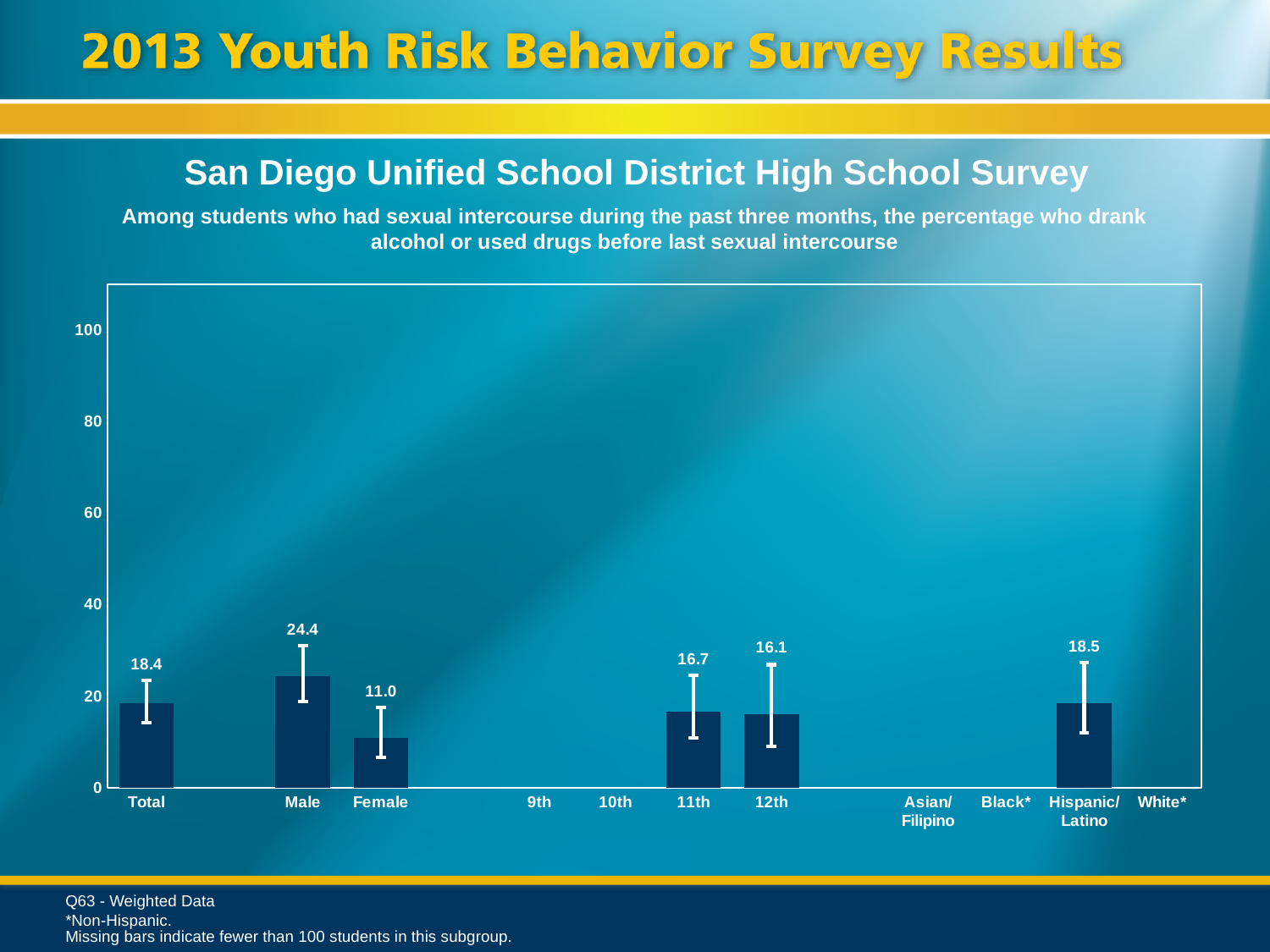
How many categories have bars plotted? 6 What is the value for Female? 11.0 What kind of chart is this? bar chart Which category with a bar has the lowest value? Female What is the difference between the Male and Female values? 13.4 Is the value for Male greater or less than 20? greater What is the value for Hispanic/Latino? 18.5 Which is larger, the value for 11th or 12th grade? 11th What is the value for Total? 18.4 Which category has the highest value? Male What is the value for Male? 24.4 What is the value for 11th grade? 16.7